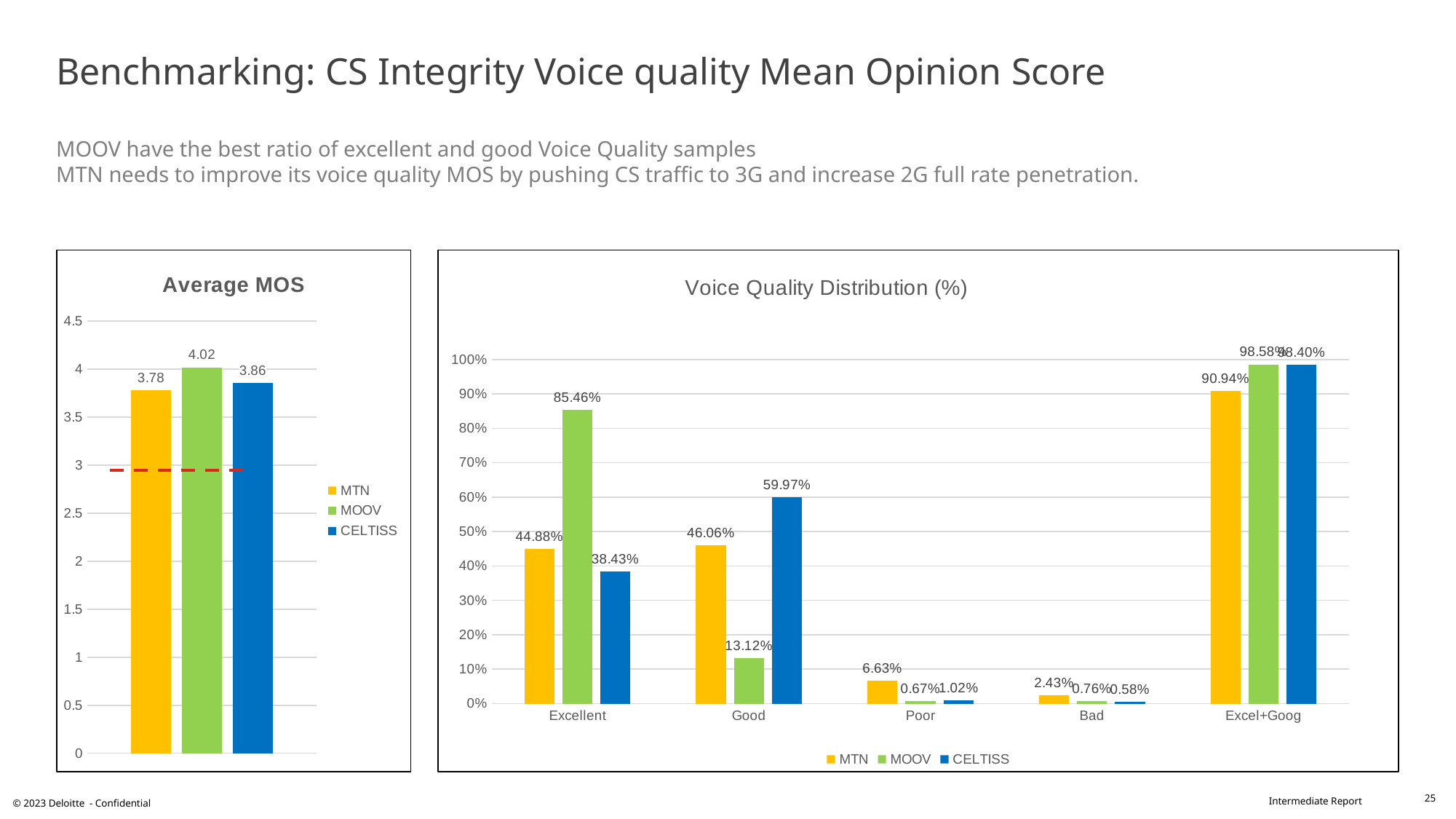
In the Voice Quality Distribution (%) chart, which is larger in the Excellent category: MTN or CELTISS? MTN In the Average MOS chart, how many series does the legend list? 3 In the Voice Quality Distribution (%) chart, what is the value for MOOV in the Excellent category? 85.46% In the Voice Quality Distribution (%) chart, how many categories are shown on the x axis? 5 In the Voice Quality Distribution (%) chart, what is the difference between the MTN and MOOV values in the Good category? 32.94% In the Average MOS chart, what is the difference between the MOOV and MTN values? 0.24 In the Average MOS chart, which operator has the lowest average MOS? MTN In the Voice Quality Distribution (%) chart, which operator has the highest value in the Poor category? MTN What kind of chart is the Average MOS chart? Bar chart In the Voice Quality Distribution (%) chart, what is the value for CELTISS in the Good category? 59.97% In the Voice Quality Distribution (%) chart, is the value for MTN in the Excel+Goog category greater or less than 90%? greater In the Average MOS chart, what is the value for MOOV? 4.02